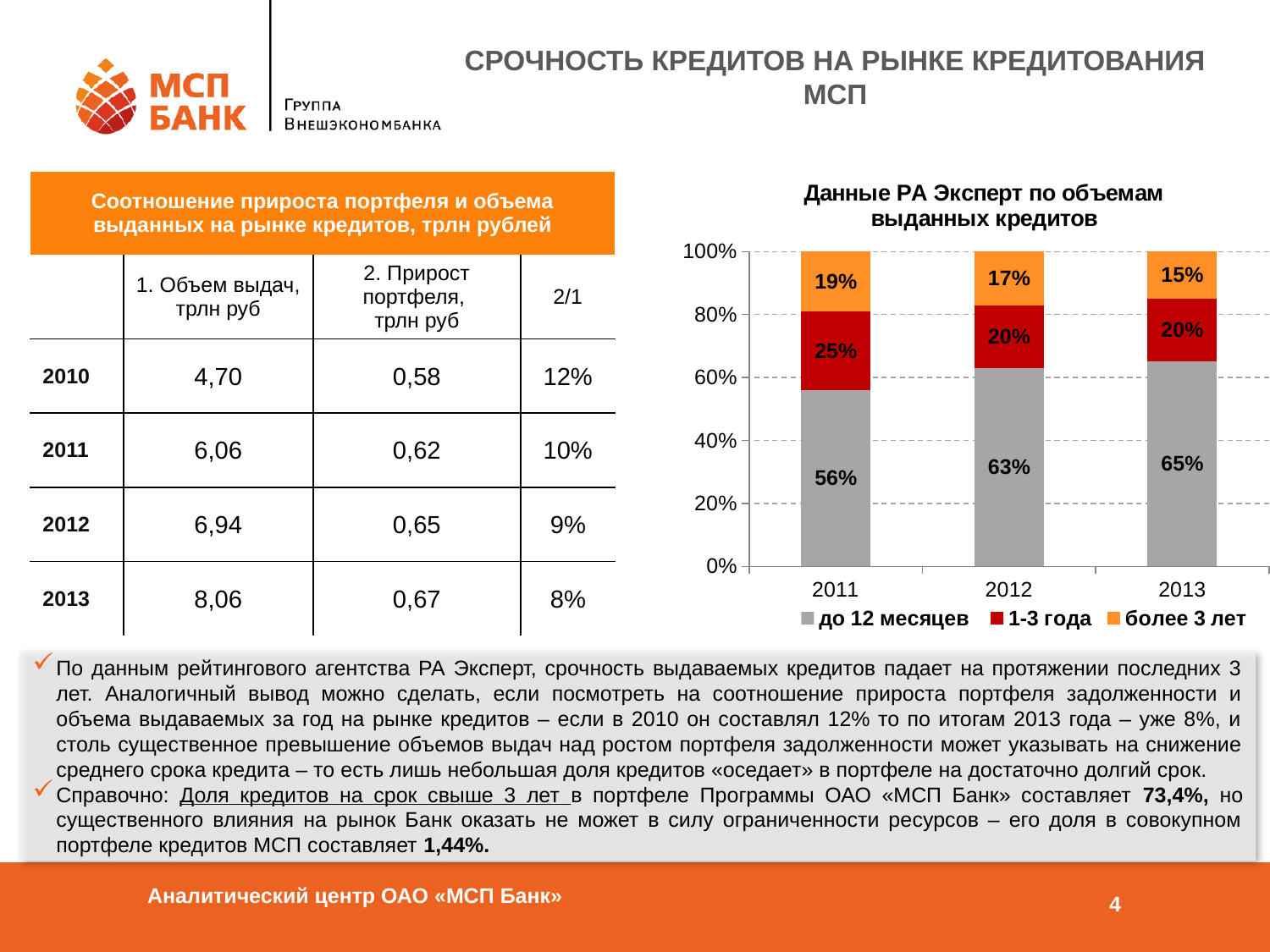
What is the difference between the "до 12 месяцев" values for 2013 and 2011? 9% What is the value for "до 12 месяцев" in 2011? 56% In which year is the share of "до 12 месяцев" highest? 2013 Which is larger: the "1-3 года" value in 2011 or in 2013? 2011 What is the title of the chart? Данные РА Эксперт по объемам выданных кредитов In which year is the share of "более 3 лет" lowest? 2013 What is the value for "1-3 года" in 2012? 20% What kind of chart is shown on the slide? Stacked bar chart How many series does the chart legend list? 3 Does the share of "более 3 лет" rise or fall from 2011 to 2013? Fall What is the value for "более 3 лет" in 2013? 15% How many years are shown on the x axis of the chart? 3